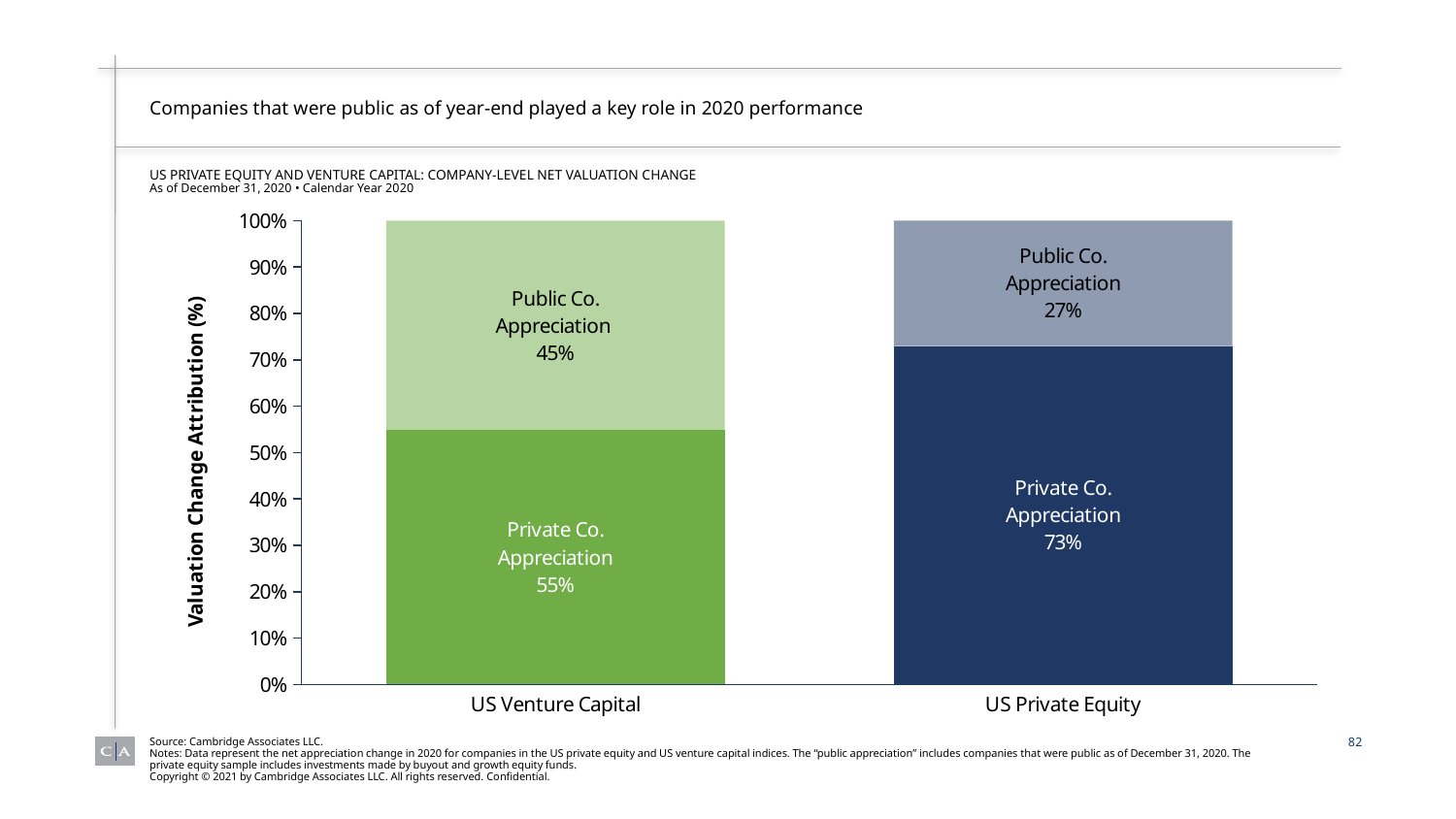
How many categories are shown on the x axis? 2 What is the Public Co. Appreciation value for US Private Equity? 27% What is the Private Co. Appreciation value for US Private Equity? 73% Which category has the higher Public Co. Appreciation share? US Venture Capital What is the difference between Public Co. Appreciation and Private Co. Appreciation for US Venture Capital? 10% What is the Private Co. Appreciation value for US Venture Capital? 55% What is the label of the y axis? Valuation Change Attribution (%) Which category has the higher Private Co. Appreciation share? US Private Equity What is the difference between the Private Co. Appreciation values for US Private Equity and US Venture Capital? 18% What kind of chart is shown on the slide? Stacked bar chart What is the Public Co. Appreciation value for US Venture Capital? 45% What is the total of the stacked bar for US Private Equity? 100%